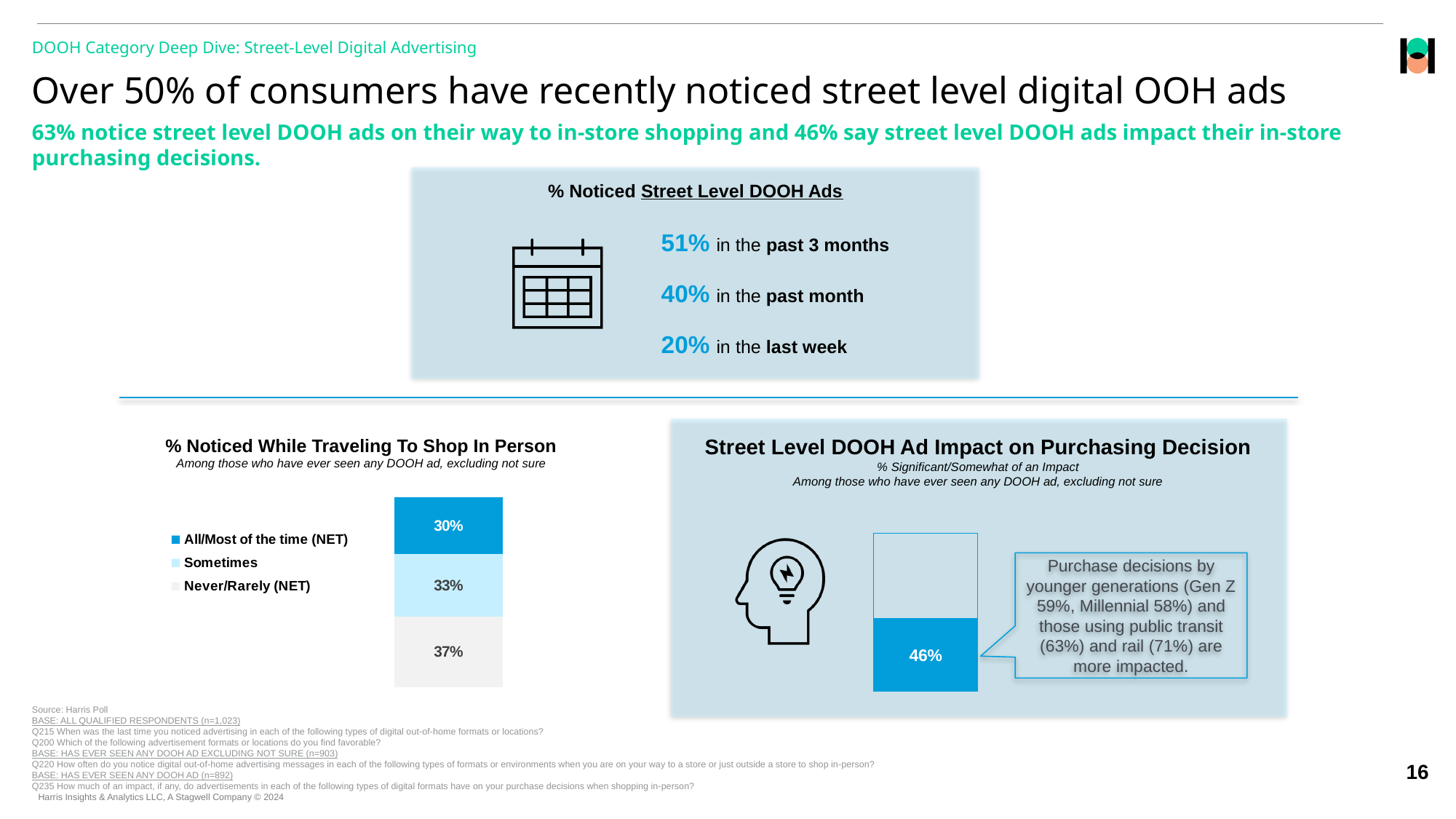
In the '% Noticed While Traveling To Shop In Person' chart, which segment has the smallest value? All/Most of the time (NET) In the '% Noticed While Traveling To Shop In Person' chart, which is larger: 'Sometimes' or 'All/Most of the time (NET)'? Sometimes In the '% Noticed While Traveling To Shop In Person' chart, which segment is shown in the darkest blue colour? All/Most of the time (NET) In the '% Noticed While Traveling To Shop In Person' chart, what percentage is shown for 'All/Most of the time (NET)'? 30% What kind of chart is the '% Noticed While Traveling To Shop In Person' chart? Stacked bar chart In the '% Noticed While Traveling To Shop In Person' chart, what percentage is shown for 'Never/Rarely (NET)'? 37% How many entries does the legend of the '% Noticed While Traveling To Shop In Person' chart list? 3 In the '% Noticed While Traveling To Shop In Person' chart, which segment has the largest value? Never/Rarely (NET) In the '% Noticed While Traveling To Shop In Person' chart, what percentage is shown for 'Sometimes'? 33% In the 'Street Level DOOH Ad Impact on Purchasing Decision' chart, what percentage is shown on the bar? 46% In the '% Noticed While Traveling To Shop In Person' chart, what is the total of the three stacked segments? 100% In the '% Noticed While Traveling To Shop In Person' chart, what is the difference between the 'Never/Rarely (NET)' and 'All/Most of the time (NET)' values? 7%